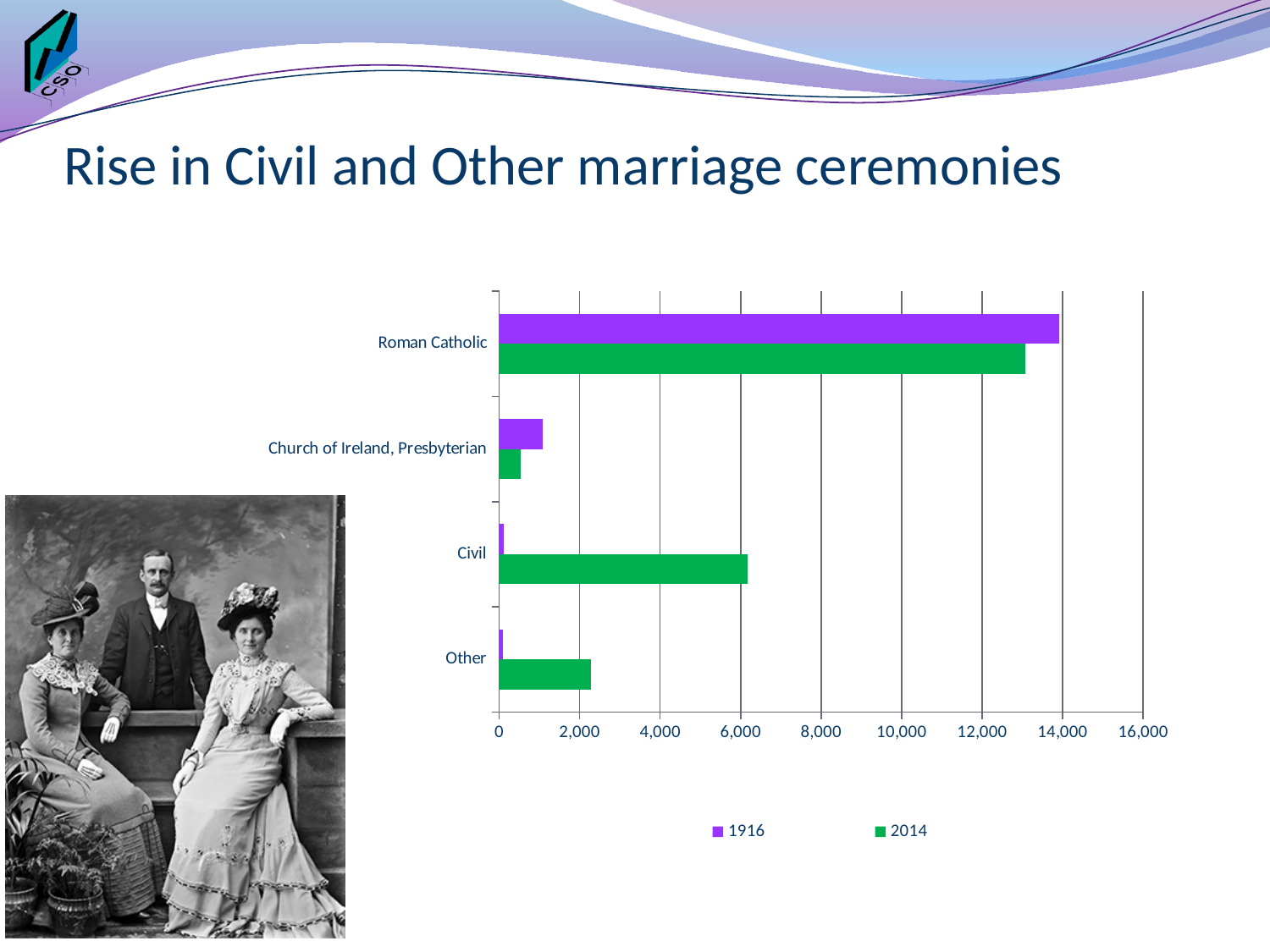
Is the 2014 value for Civil greater or less than 4,000? greater For Roman Catholic ceremonies, which series has the larger value, 1916 or 2014? 1916 Is the 1916 value for Roman Catholic greater or less than 12,000? greater Is the 1916 value for Church of Ireland, Presbyterian greater or less than 2,000? less For Civil ceremonies, which series has the larger value, 1916 or 2014? 2014 Which category has the highest value for 1916? Roman Catholic What kind of chart is shown on the slide? bar chart How many categories are shown on the chart? 4 Which series is shown in green in the legend? 2014 Which category has the lowest value for 2014? Church of Ireland, Presbyterian Which category has the highest value for 2014? Roman Catholic How many series does the chart's legend list? 2